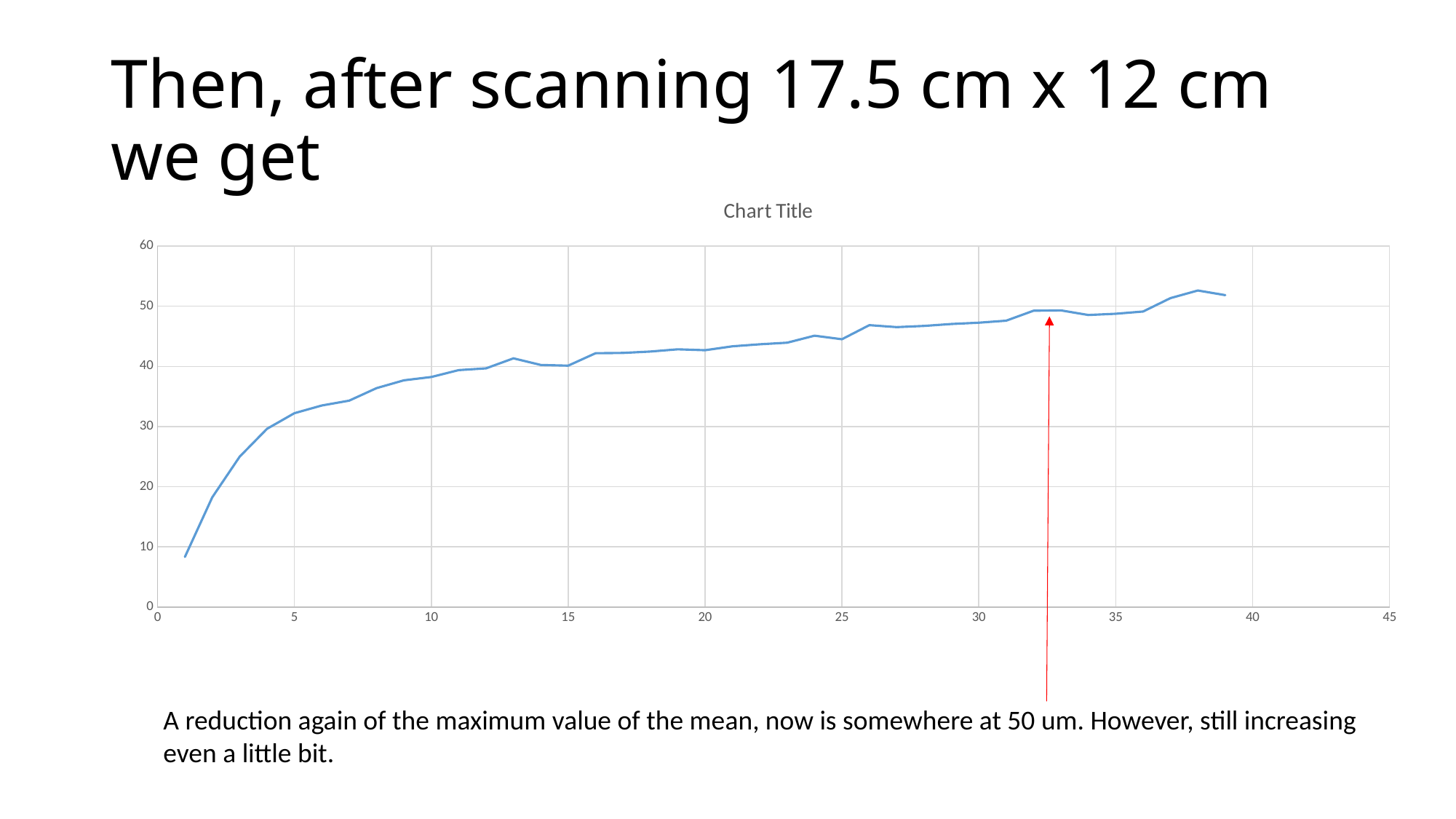
Is the value at x = 5 greater or less than 30? greater What is the title shown above the chart? Chart Title Is the value at x = 38 greater or less than 50? greater Do the plotted values generally rise or fall as the x-axis value increases? rise Is the value at x = 1 greater or less than 10? less How many lines are plotted on the chart? 1 What kind of chart is shown on the slide? line chart What is the highest value labelled on the y-axis? 60